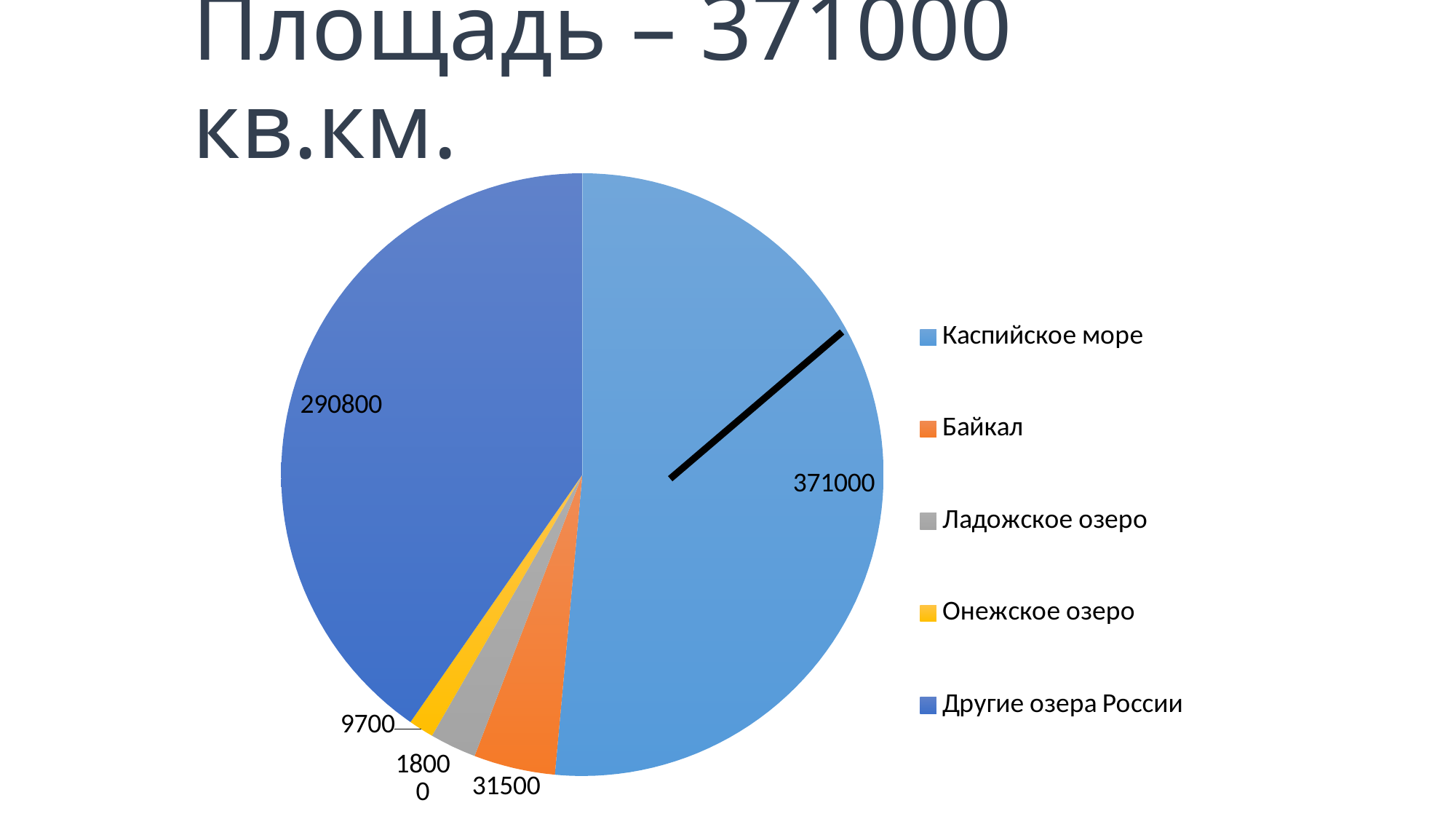
What type of chart is shown on the slide? pie chart How many slices does the pie chart have? 5 What colour is the slice for Онежское озеро? yellow What is the value for Другие озера России? 290800 What is the value for Ладожское озеро? 18000 Which is larger, the value for Байкал or the value for Ладожское озеро? Байкал What is the value for Онежское озеро? 9700 What is the difference between the values for Каспийское море and Другие озера России? 80200 What is the value for Байкал? 31500 What is the value for Каспийское море? 371000 Which category has the smallest slice? Онежское озеро Which category has the largest slice? Каспийское море